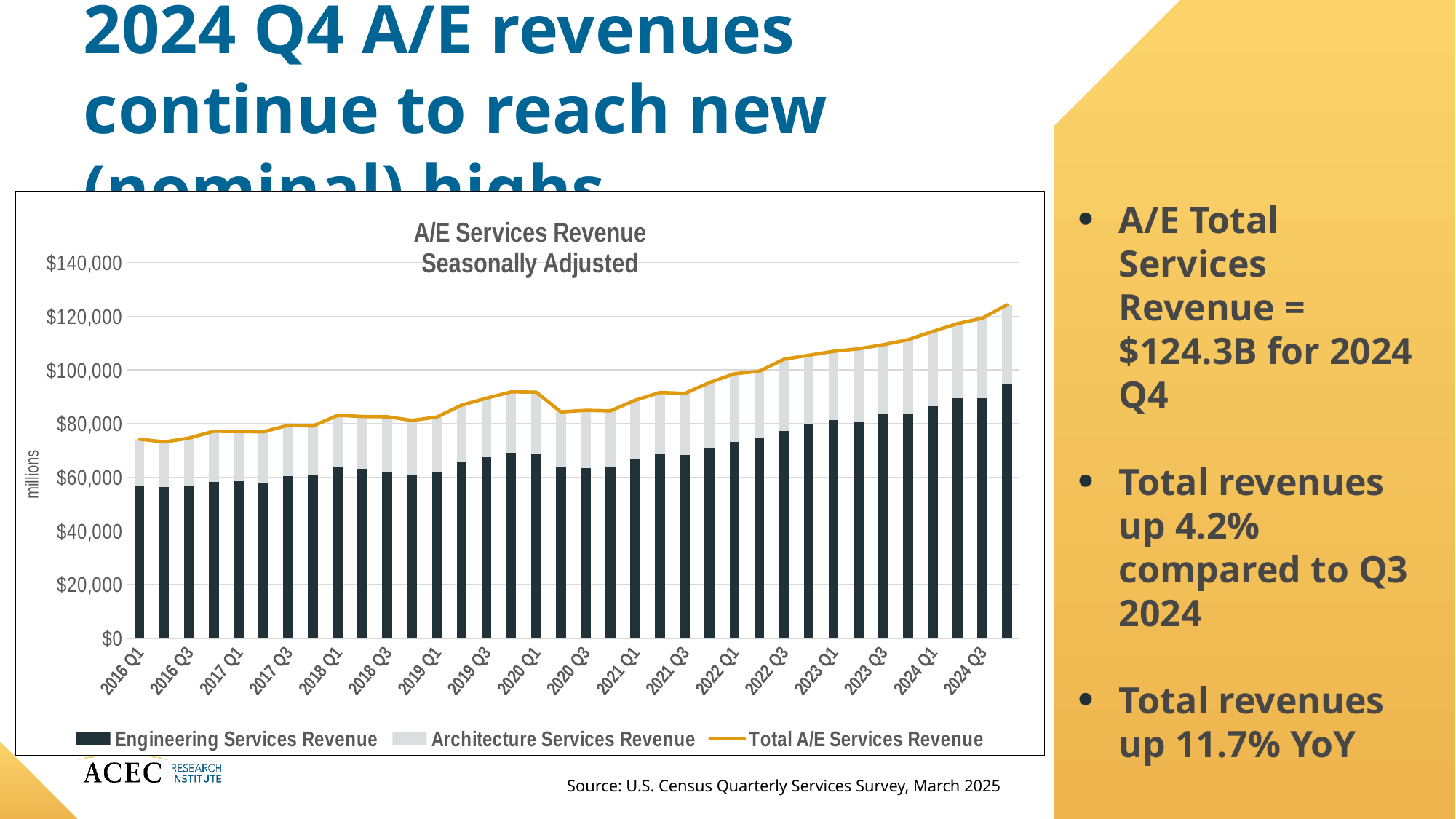
Is the Total A/E Services Revenue for 2016 Q1 greater or less than $80,000? less What kind of chart is shown on the slide? Stacked bar chart with a line Which is larger: Engineering Services Revenue in 2024 Q4 or in 2016 Q1? 2024 Q4 How many series does the chart legend list? 3 Is the Engineering Services Revenue for 2016 Q1 greater or less than $60,000? less Which series is shown as a line rather than bars? Total A/E Services Revenue Is the Engineering Services Revenue for 2024 Q3 greater or less than $80,000? greater In 2024 Q4, which is larger: Engineering Services Revenue or Architecture Services Revenue? Engineering Services Revenue Does Total A/E Services Revenue generally rise or fall from 2016 Q1 to 2024 Q4? Rise Which quarter has the highest Total A/E Services Revenue? 2024 Q4 What is the title of the chart? A/E Services Revenue Seasonally Adjusted